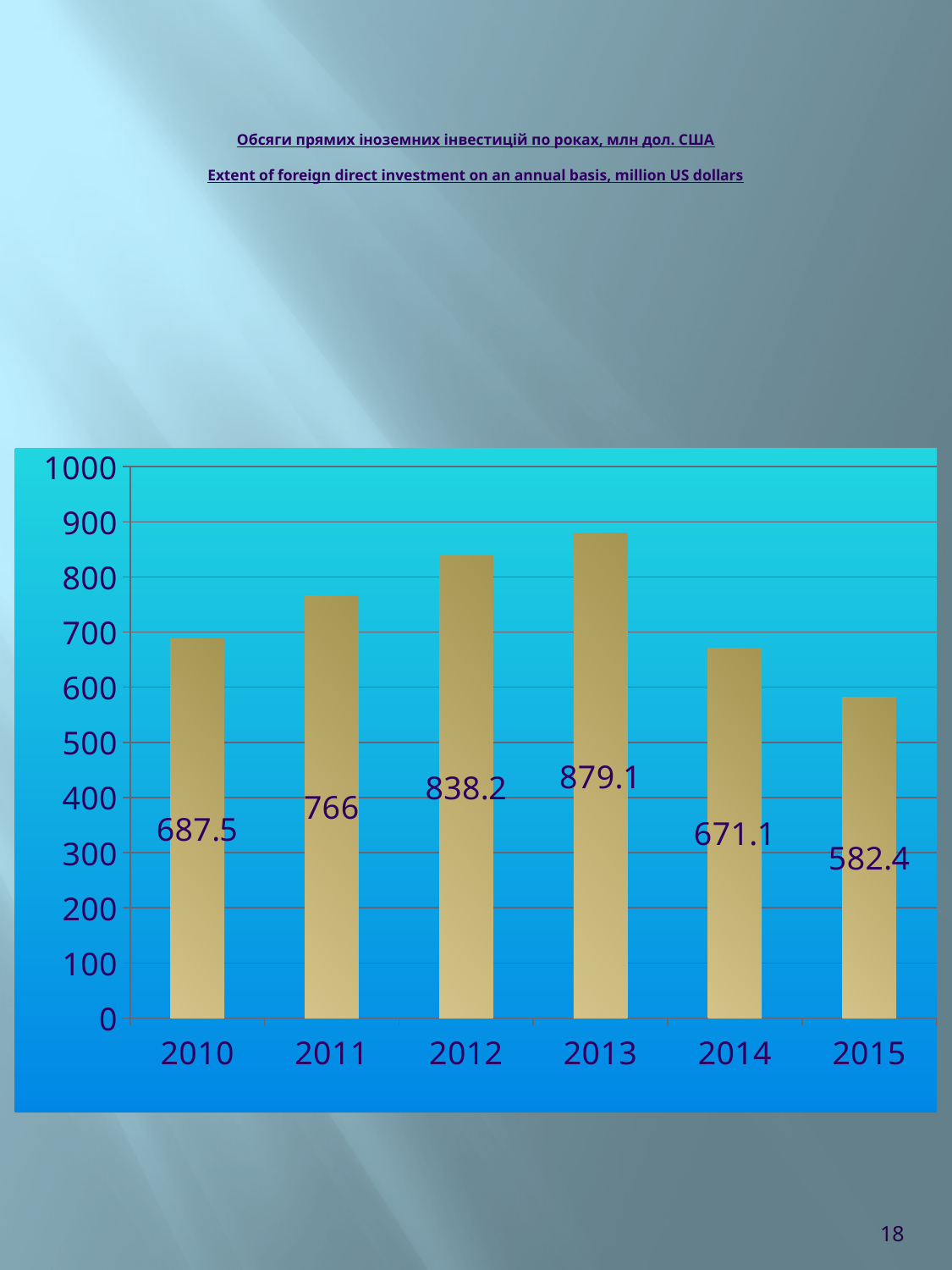
What is the difference between the values for 2011 and 2015? 183.6 Is the value for 2012 greater or less than 800? greater What is the value for 2013? 879.1 How many years are shown on the x axis? 6 Do the values rise or fall from 2013 to 2015? fall What kind of chart is shown on the slide? bar chart What is the value for 2010? 687.5 Which is larger, the value for 2010 or the value for 2014? 2010 What is the value for 2015? 582.4 What is the difference between the values for 2013 and 2012? 40.9 Which year has the highest value? 2013 Which year has the lowest value? 2015